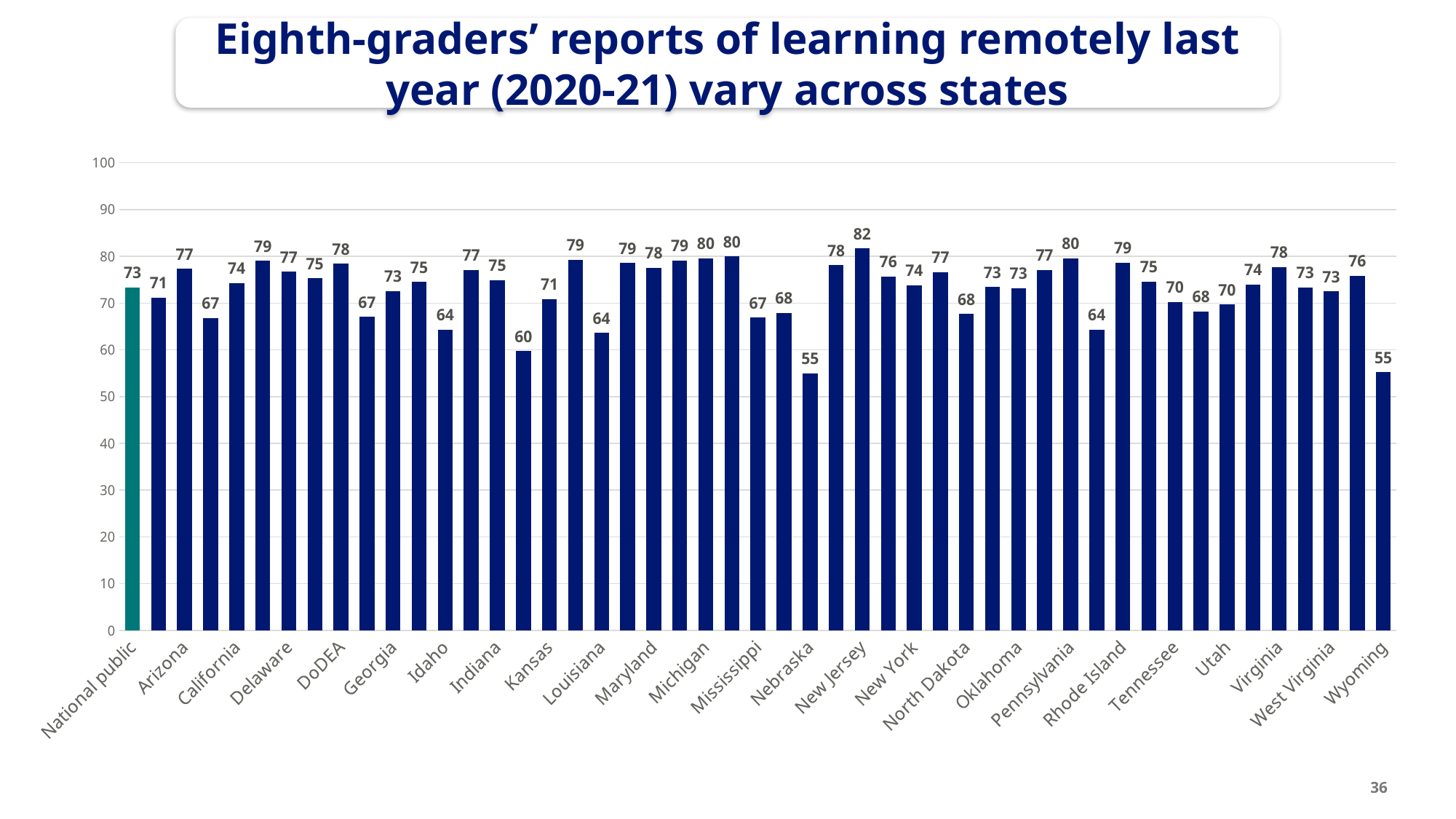
What is the value for National public? 73 What kind of chart is shown on the slide? bar chart What is the lowest value shown on the chart? 55 What is the value for Michigan? 80 What is the value for New Jersey? 82 What is the difference between the value for New Jersey and the value for National public? 9 Which is larger, the value for Michigan or the value for Idaho? Michigan Is the value for Wyoming greater or less than 60? less Which category has the highest value? New Jersey Which bar is shown in a different colour (teal) from the rest? National public What is the value for Wyoming? 55 What is the value for Nebraska? 55